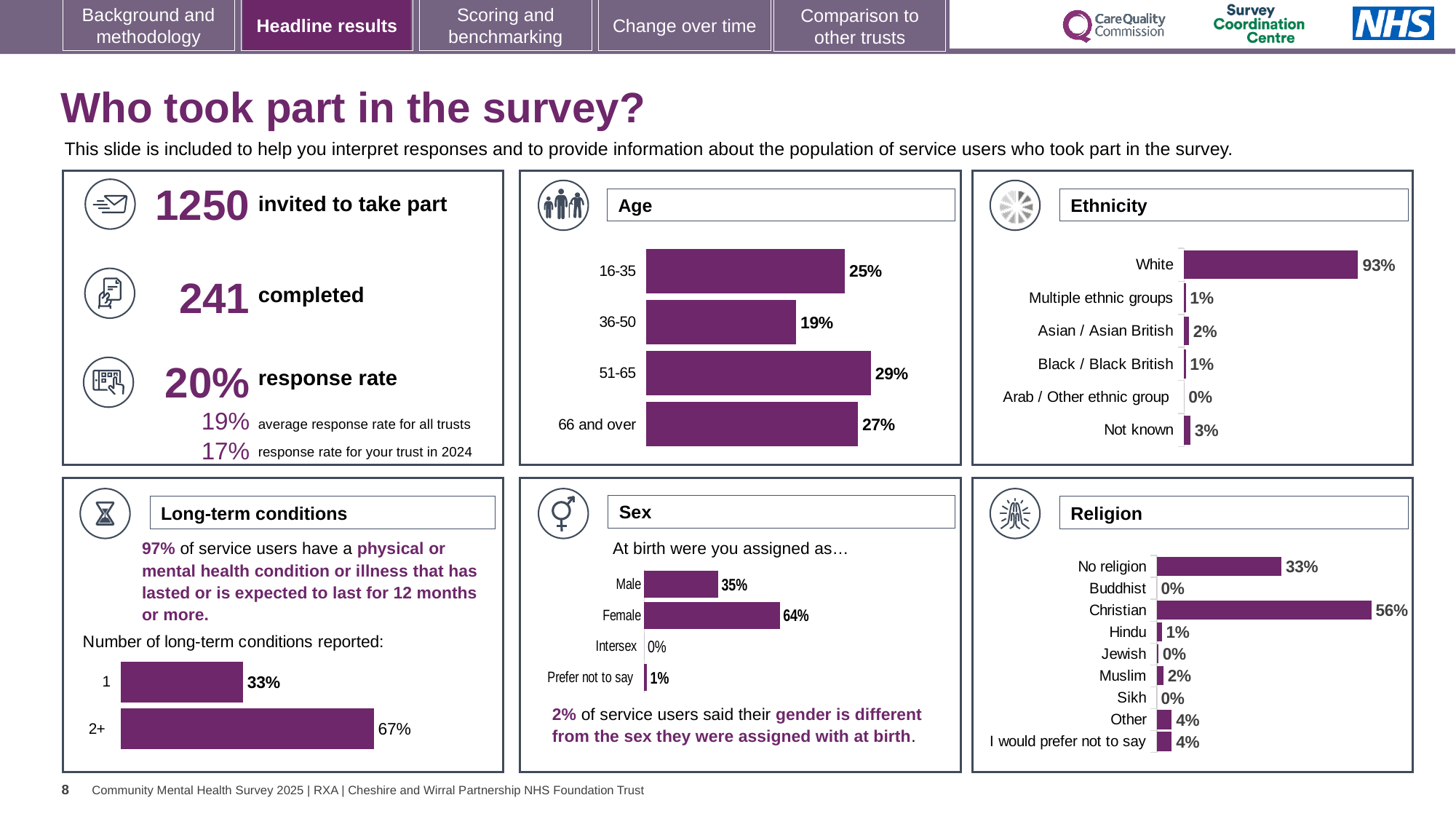
In the Ethnicity chart, which category is larger: Asian / Asian British or Not known? Not known In the Ethnicity chart, how many ethnicity categories are shown? 6 In the Sex chart, what is the difference between Female and Male? 29% In the Sex chart, what percentage of respondents were assigned Female at birth? 64% In the Long-term conditions chart, what percentage of service users reported 2+ long-term conditions? 67% In the Age chart, what percentage of respondents were aged 51-65? 29% In the Ethnicity chart, what percentage of respondents were White? 93% What type of chart is used in the Age panel? Bar chart In the Religion chart, what percentage of respondents reported No religion? 33% In the Age chart, which age group has the lowest percentage? 36-50 In the Age chart, what is the difference between the 66 and over group and the 16-35 group? 2% In the Religion chart, which religion category has the highest percentage? Christian